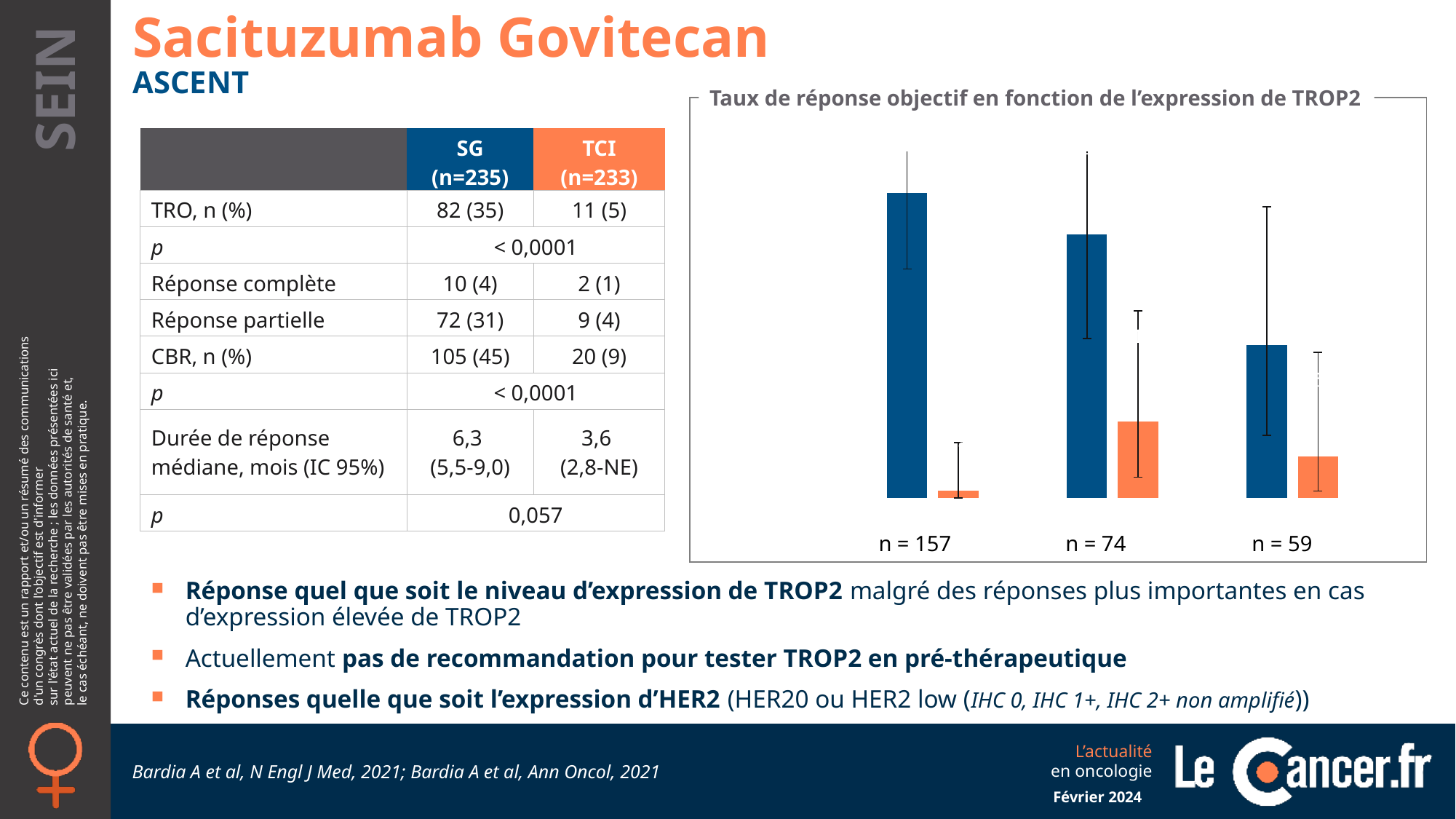
Which category has the shortest orange bar in the chart? n = 157 What kind of chart is shown under the title "Taux de réponse objectif en fonction de l'expression de TROP2"? Bar chart In the n = 59 group, which bar is taller, the blue one or the orange one? The blue one Do the blue bars rise or fall from left to right across the x axis? Fall How many groups of bars are shown on the x axis of the chart? 3 Which category has the shortest blue bar in the chart? n = 59 What is the title of the chart on the slide? Taux de réponse objectif en fonction de l'expression de TROP2 Which category has the tallest orange bar in the chart? n = 74 In the n = 157 group, which bar is taller, the blue one or the orange one? The blue one Which category has the tallest blue bar in the chart? n = 157 Is the blue bar for n = 74 taller or shorter than the blue bar for n = 59? Taller What are the three category labels on the x axis of the chart? n = 157, n = 74, n = 59